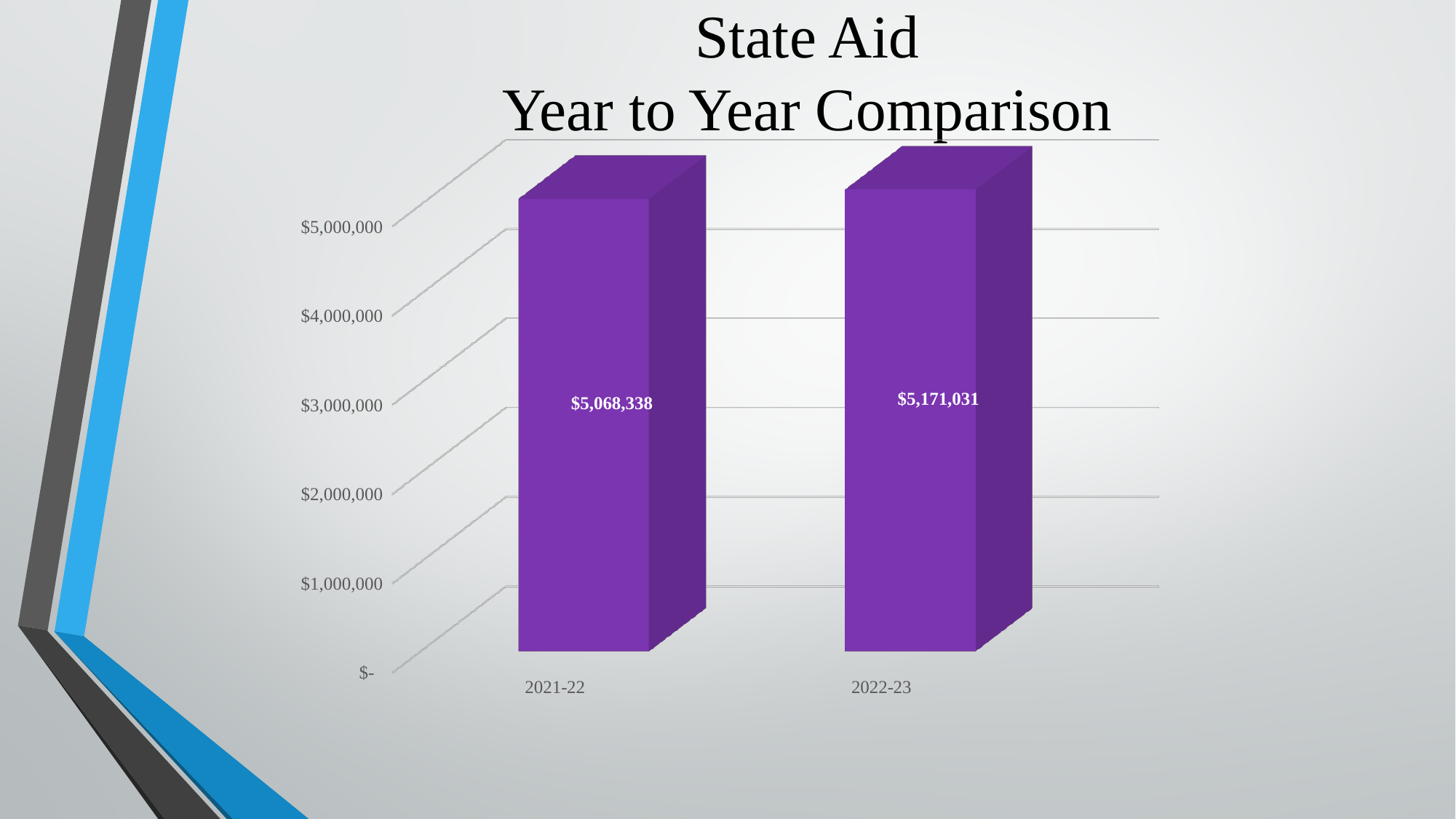
Which year has the lower State Aid value? 2021-22 What colour are the bars in the chart? purple How many years are shown on the chart? 2 Which year has the higher State Aid value? 2022-23 What is the difference between the State Aid values for 2022-23 and 2021-22? $102,693 What is the title of the chart? State Aid Year to Year Comparison Is the State Aid value for 2021-22 larger or smaller than the value for 2022-23? smaller What is the State Aid value for 2022-23? $5,171,031 What is the State Aid value for 2021-22? $5,068,338 Is the State Aid value for 2022-23 greater or less than $5,000,000? greater What kind of chart is shown on the slide? bar chart Does the State Aid value rise or fall from 2021-22 to 2022-23? rise